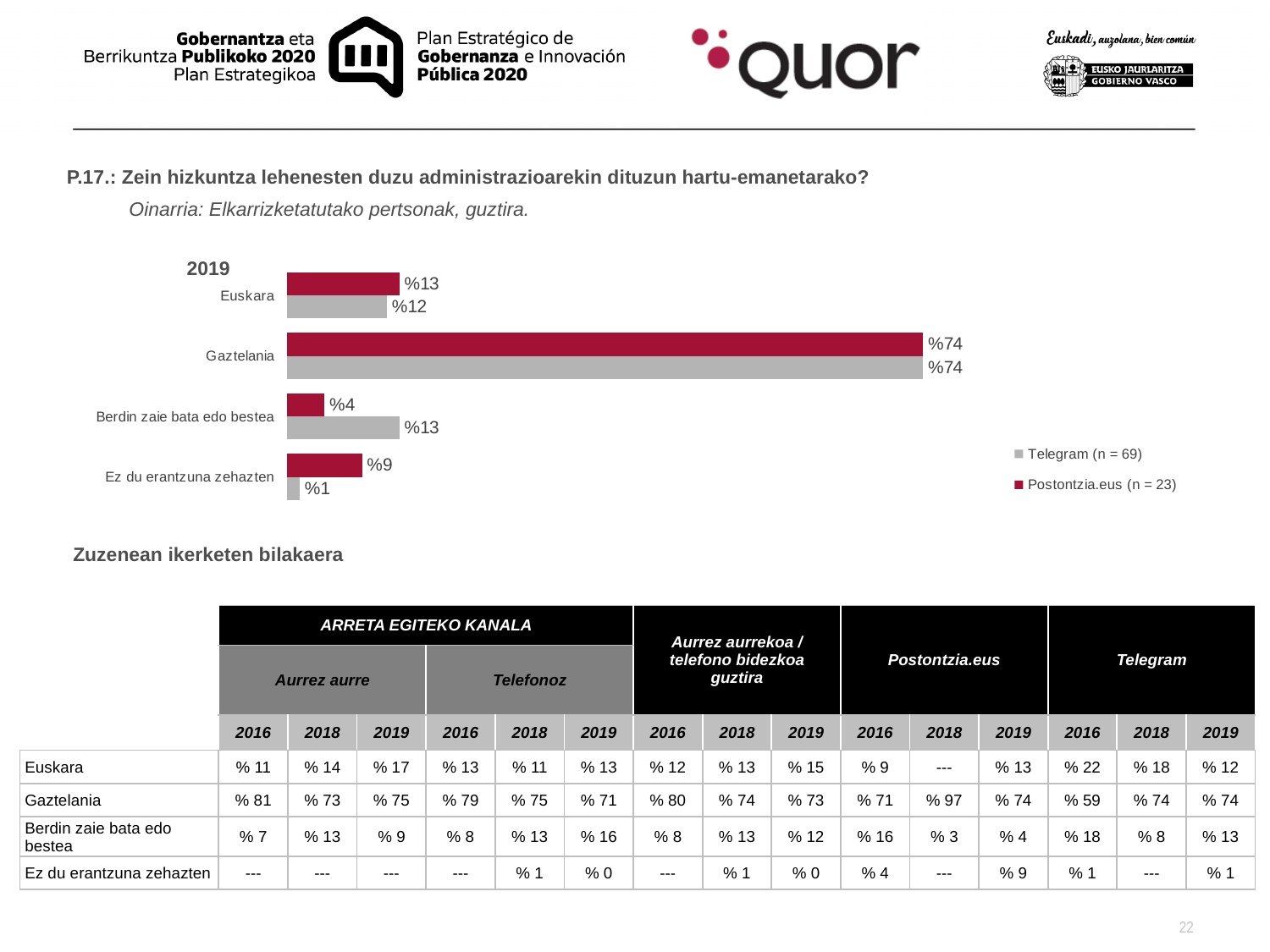
What is the value for Gaztelania in the Telegram series? %74 How many series does the chart legend list? 2 Which category has the highest value in the Postontzia.eus series? Gaztelania What is the value for Ez du erantzuna zehazten in the Telegram series? %1 What is the value for Euskara in the Postontzia.eus series? %13 What is the value for Euskara in the Telegram series? %12 How many categories are shown on the chart? 4 Which category has the lowest value in the Telegram series? Ez du erantzuna zehazten What is the value for Berdin zaie bata edo bestea in the Postontzia.eus series? %4 For Ez du erantzuna zehazten, which series has the larger value, Telegram or Postontzia.eus? Postontzia.eus What kind of chart is shown on the slide? bar chart What is the difference between the Telegram and Postontzia.eus values for Berdin zaie bata edo bestea? %9